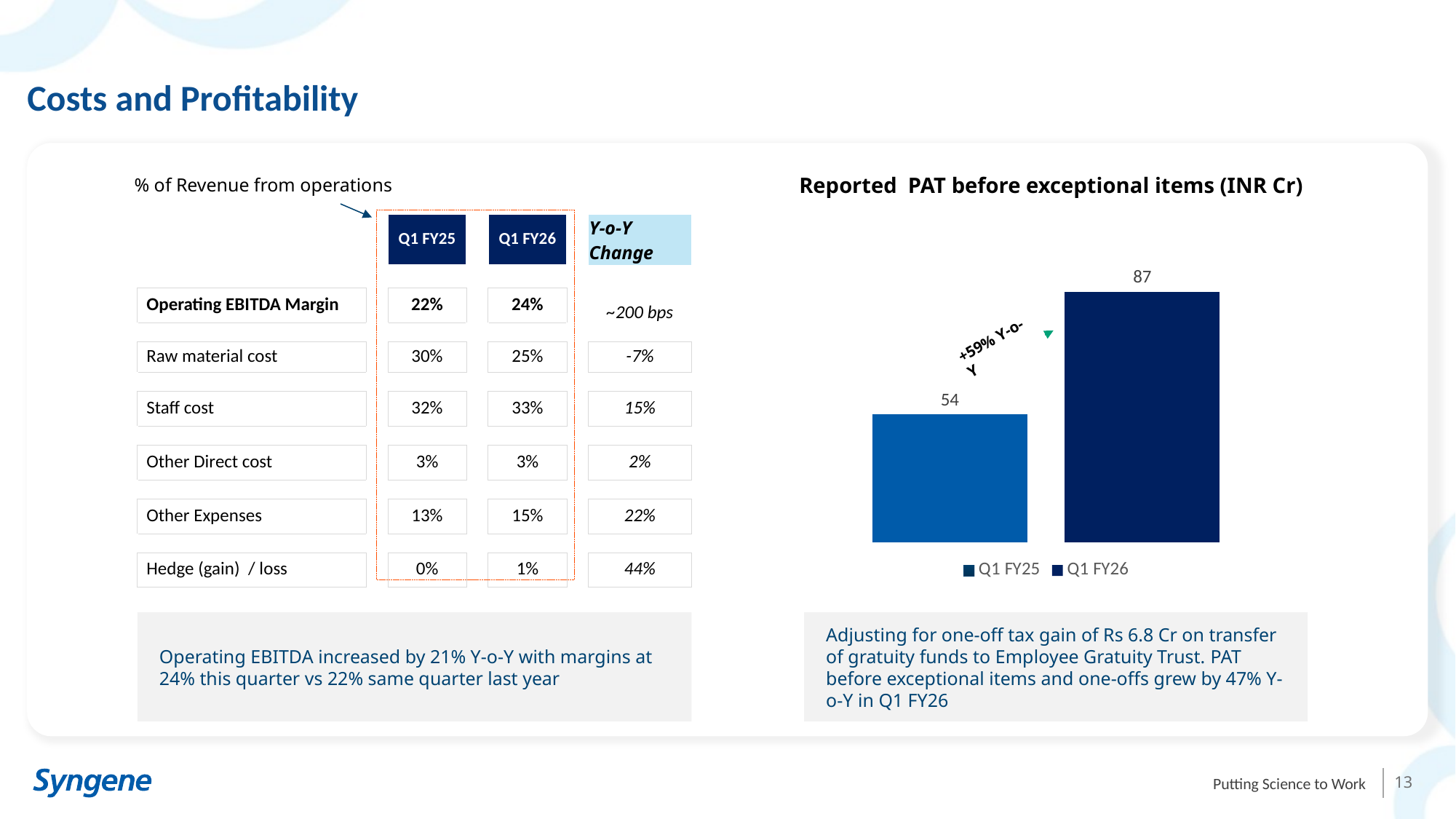
What is the value for Q1 FY26 in the Reported PAT before exceptional items chart? 87 Which bar is highest in the Reported PAT before exceptional items chart? Q1 FY26 What is the difference between the Q1 FY26 and Q1 FY25 values in the Reported PAT before exceptional items chart? 33 How many bars are plotted in the Reported PAT before exceptional items chart? 2 Do the values rise or fall from Q1 FY25 to Q1 FY26 in the Reported PAT before exceptional items chart? Rise How many entries does the legend of the Reported PAT before exceptional items chart list? 2 In the Reported PAT before exceptional items chart, which is larger, Q1 FY25 or Q1 FY26? Q1 FY26 What is the value for Q1 FY25 in the Reported PAT before exceptional items chart? 54 What Y-o-Y change is annotated on the Reported PAT before exceptional items chart? +59% Y-o-Y What kind of chart is the Reported PAT before exceptional items chart? Bar chart Which bar is lowest in the Reported PAT before exceptional items chart? Q1 FY25 What unit is given in the title of the Reported PAT before exceptional items chart? INR Cr